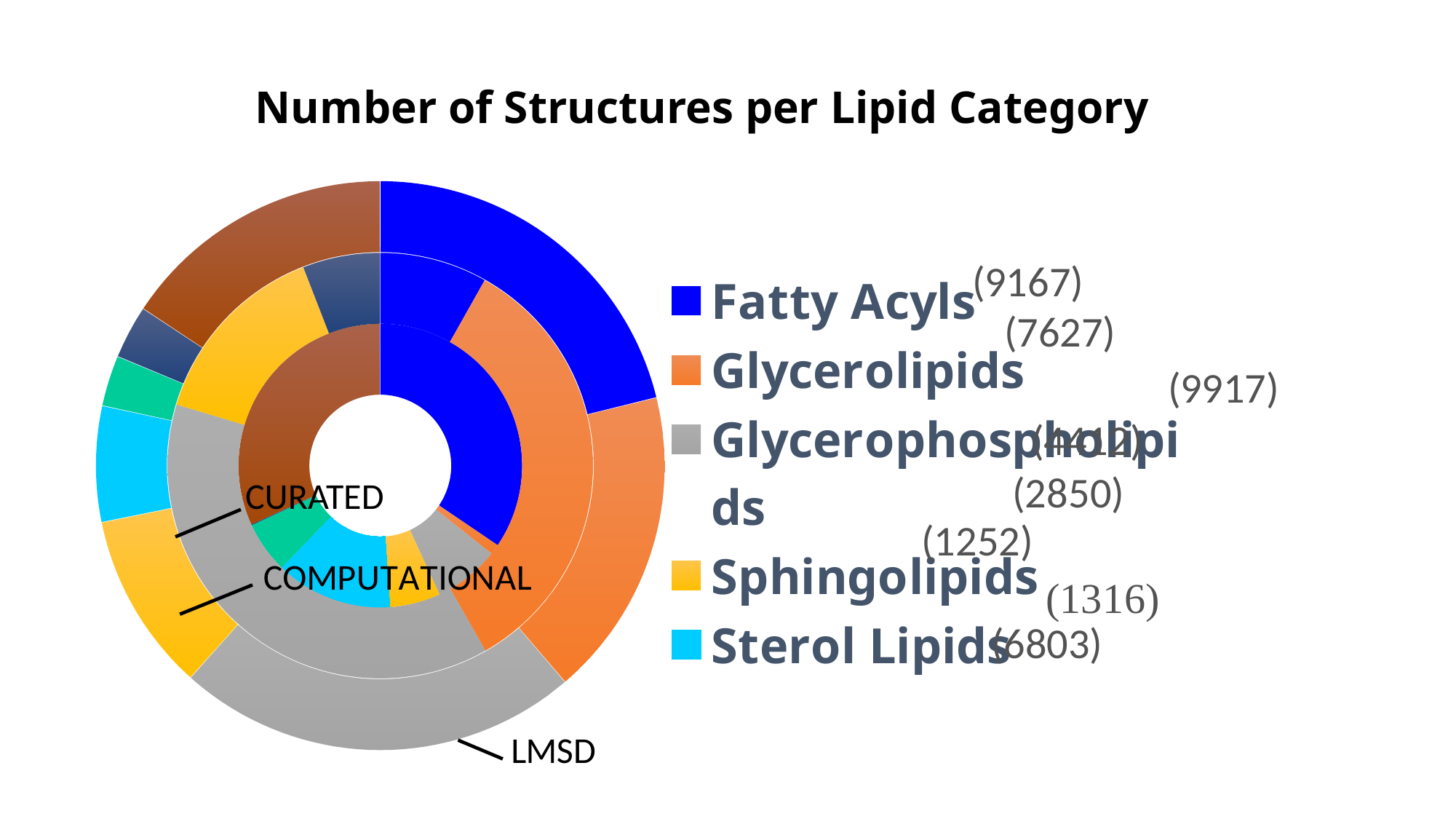
How many lipid categories does the legend list? 5 What is the title of the chart? Number of Structures per Lipid Category In the outer LMSD ring, which slice is larger: Fatty Acyls or Sterol Lipids? Fatty Acyls In the outer LMSD ring, which lipid category has the largest slice? Glycerophospholipids In the outer LMSD ring, which of the legend's lipid categories has the smallest slice? Sterol Lipids In the innermost CURATED ring, which lipid category has the largest slice? Fatty Acyls What kind of chart is shown on the slide? Doughnut (pie) chart What are the three rings of the doughnut chart labelled? CURATED, COMPUTATIONAL, LMSD How many concentric rings does the doughnut chart have? 3 In the innermost CURATED ring, which slice is larger: Fatty Acyls or Glycerolipids? Fatty Acyls